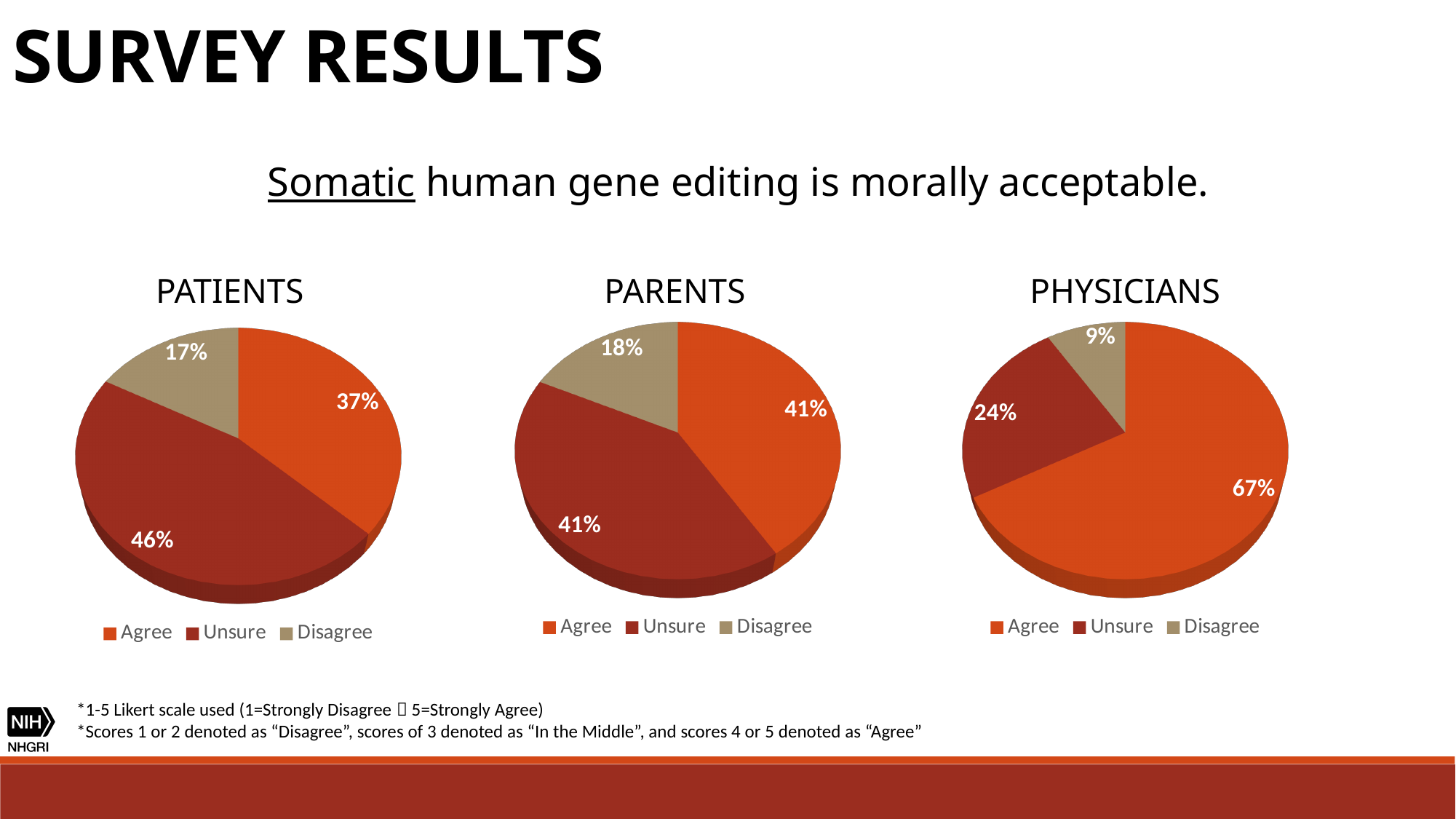
How many slices does the PARENTS pie chart have? 3 What type of chart is used for the PHYSICIANS data? Pie chart In the PATIENTS pie chart, what is the difference between the Unsure and Agree shares? 9% In the PHYSICIANS pie chart, what is the difference between the Agree and Unsure shares? 43% In the PHYSICIANS pie chart, what percentage of respondents chose Unsure? 24% In the PHYSICIANS pie chart, what percentage of respondents chose Agree? 67% In the PHYSICIANS pie chart, which response category has the smallest share? Disagree In the PARENTS pie chart, what percentage of respondents chose Disagree? 18% Which is larger: the Agree share in the PARENTS chart or the Agree share in the PATIENTS chart? PARENTS In the PATIENTS pie chart, which response category has the largest share? Unsure In the PATIENTS pie chart, what percentage of respondents chose Unsure? 46% In the PATIENTS pie chart, what percentage of respondents chose Agree? 37%